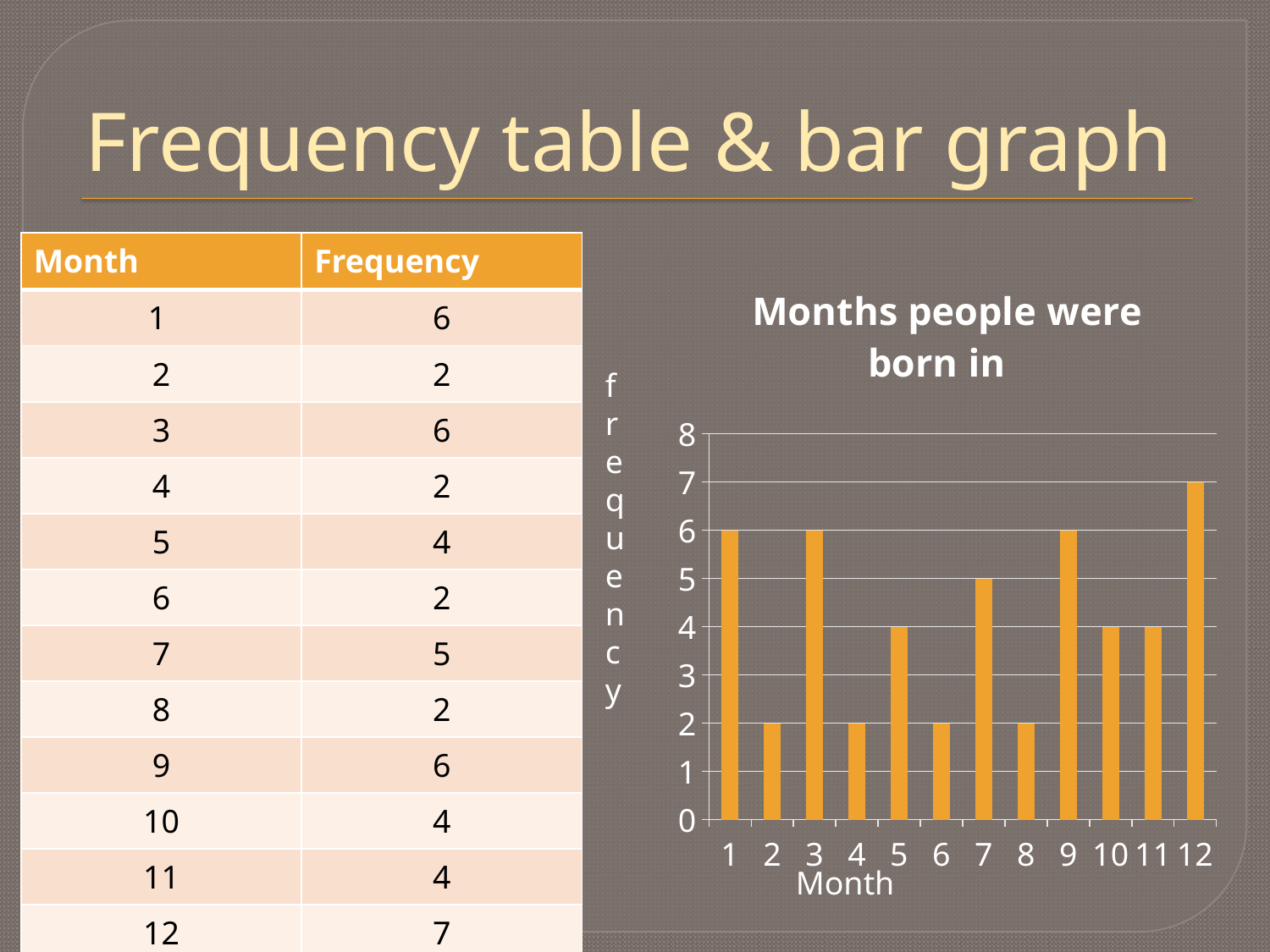
What is the frequency for month 12 in the chart? 7 How many months (categories) are plotted on the x axis of the chart? 12 Is the frequency for month 1 greater or less than 4? greater What is the title of the chart? Months people were born in Which has a higher frequency in the chart, month 9 or month 10? month 9 What type of chart is shown on the slide? bar chart What is the frequency for month 7 in the chart? 5 What is the difference between the frequency for month 12 and the frequency for month 2? 5 Which month has the highest frequency in the chart? 12 What is the difference between the frequency for month 3 and the frequency for month 11? 2 What is the frequency for month 5 in the chart? 4 What label is shown on the x axis of the chart? Month